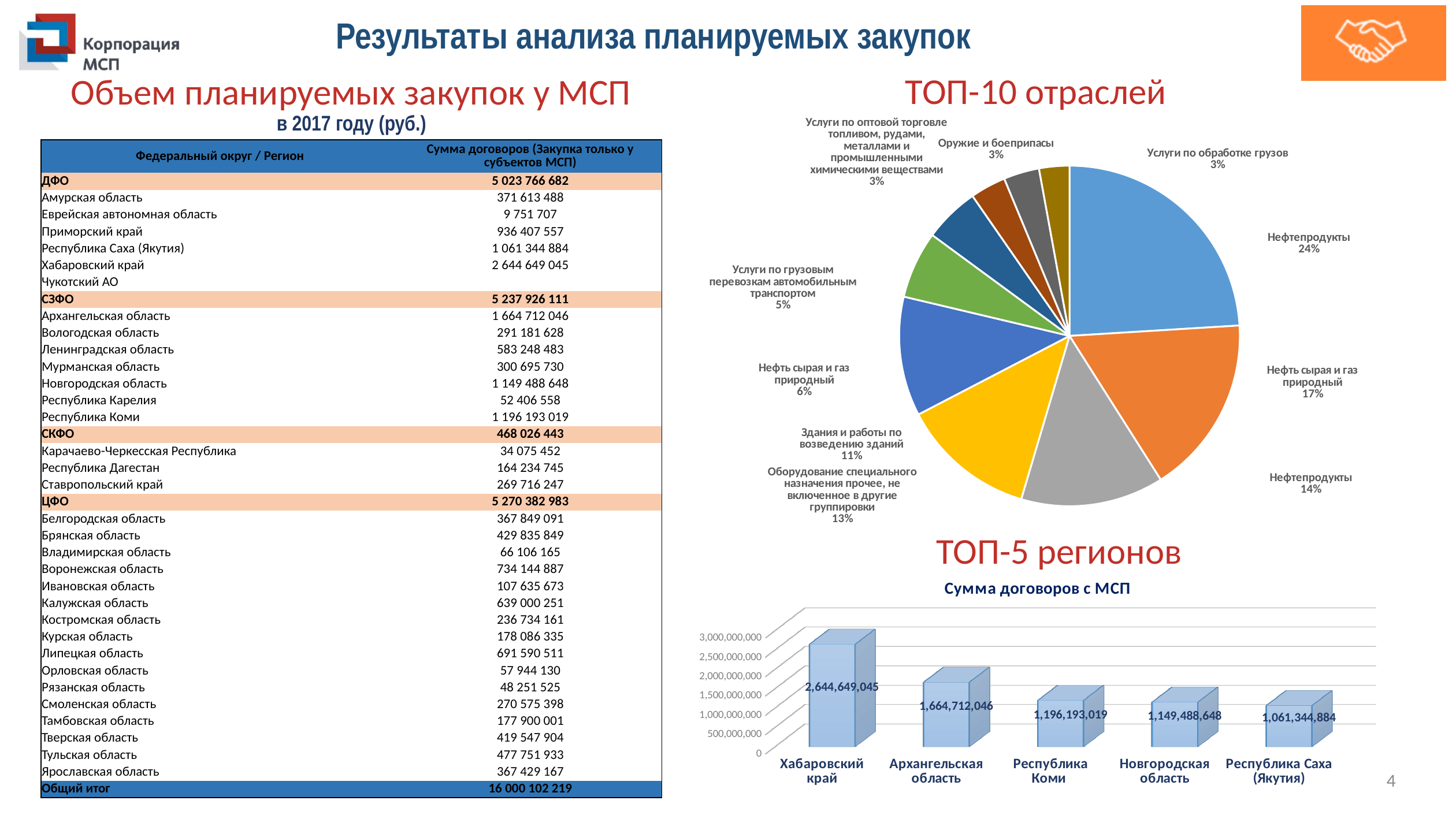
In the ТОП-5 регионов chart, what is the value for Хабаровский край? 2,644,649,045 In the ТОП-5 регионов chart, which region has the lowest value? Республика Саха (Якутия) In the ТОП-5 регионов chart, how many regions are shown? 5 In the ТОП-10 отраслей pie chart, what share does Здания и работы по возведению зданий have? 11% In the ТОП-10 отраслей pie chart, how many slices are there? 10 What kind of chart is the ТОП-5 регионов chart? bar chart In the ТОП-5 регионов chart, which region has the highest value? Хабаровский край In the ТОП-5 регионов chart, what is the value for Республика Коми? 1,196,193,019 In the ТОП-5 регионов chart, what is the value for Республика Саха (Якутия)? 1,061,344,884 In the ТОП-5 регионов chart, what is the difference between Хабаровский край and Архангельская область? 979,936,999 In the ТОП-5 регионов chart, is the value for Архангельская область greater or less than 1,500,000,000? greater In the ТОП-10 отраслей pie chart, what share does the largest slice, Нефтепродукты, have? 24%